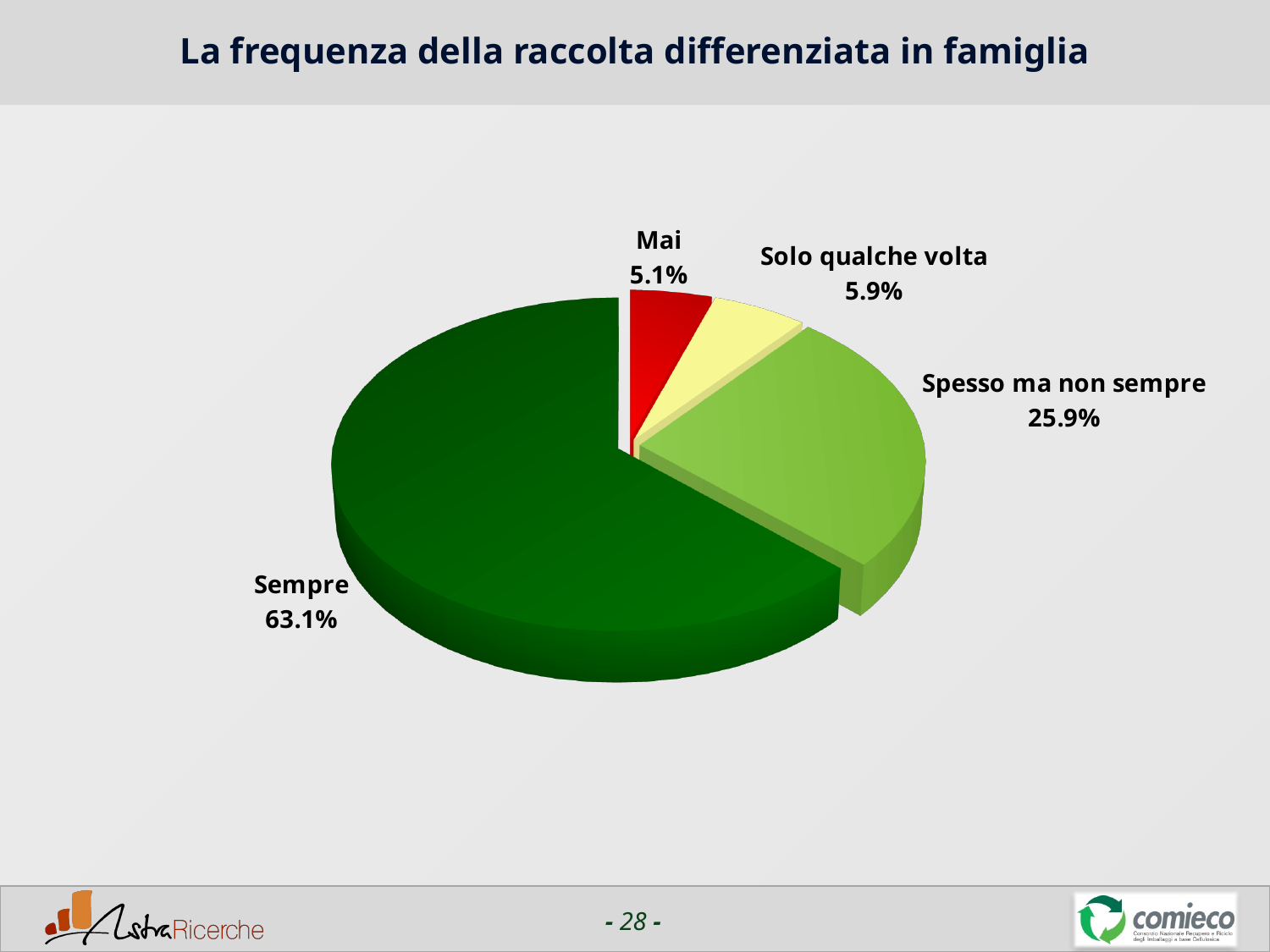
How many categories does the pie chart show? 4 What is the title of the slide? La frequenza della raccolta differenziata in famiglia Which is larger, the value for Spesso ma non sempre or the value for Solo qualche volta? Spesso ma non sempre What is the difference between the values for Solo qualche volta and Mai? 0.8% What kind of chart is shown on the slide? pie chart What is the value for Solo qualche volta? 5.9% Which category has the smallest share of the pie? Mai What is the difference between the values for Sempre and Spesso ma non sempre? 37.2% Which category has the largest share of the pie? Sempre What is the value for Spesso ma non sempre? 25.9% What is the value for Mai? 5.1% What is the value for Sempre? 63.1%